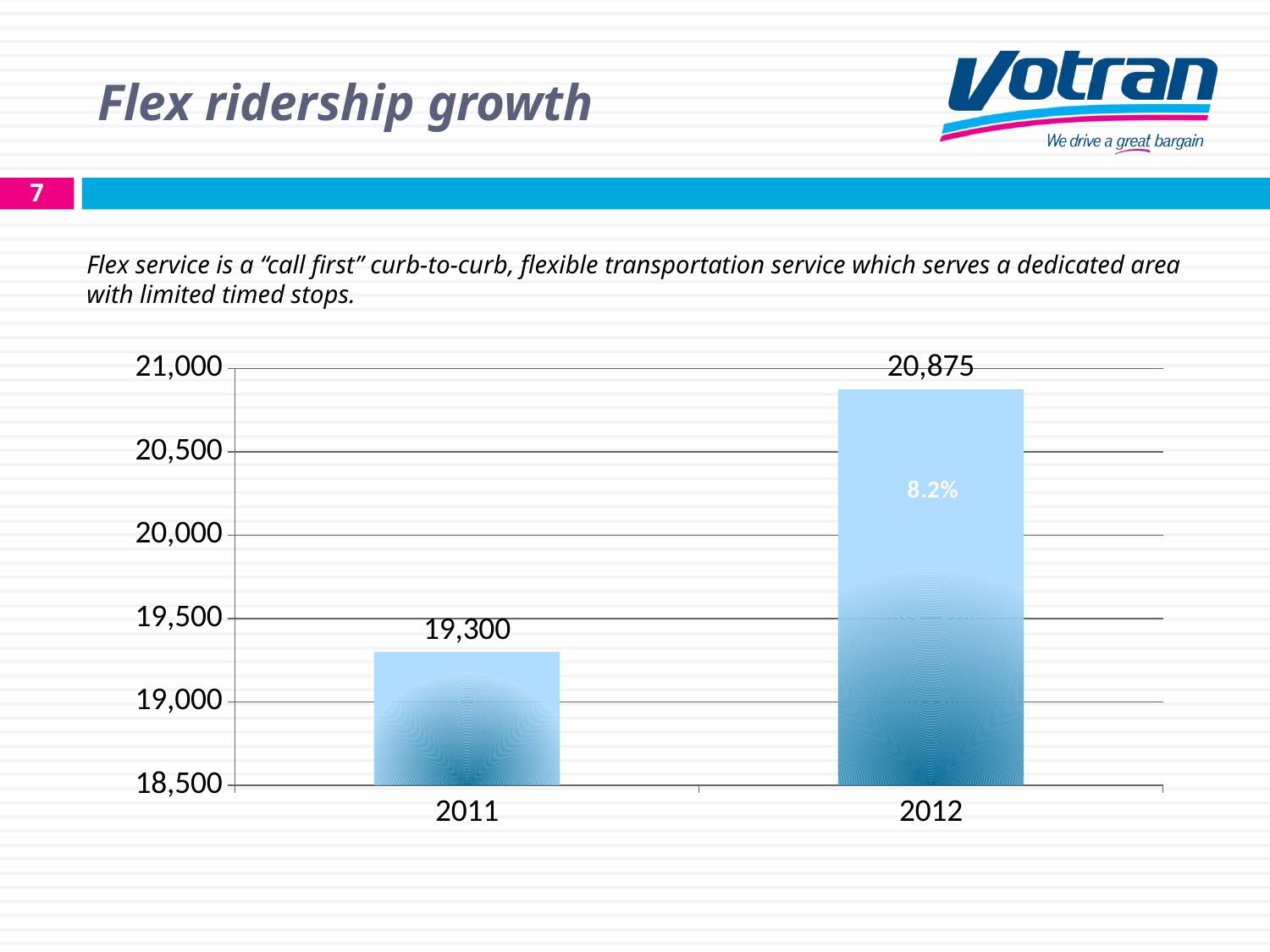
Is the value for 2012 greater or less than 20,500? greater Which year has the higher Flex ridership? 2012 What percentage growth is printed on the 2012 bar? 8.2% Which year has the lower Flex ridership? 2011 What kind of chart is shown on the slide? bar chart Is the value for 2011 greater or less than 19,500? less Is the Flex ridership for 2012 larger or smaller than for 2011? larger How many years are shown on the chart? 2 Does Flex ridership rise or fall from 2011 to 2012? rise What is the Flex ridership value for 2012? 20,875 What is the Flex ridership value for 2011? 19,300 What is the difference in Flex ridership between 2012 and 2011? 1,575